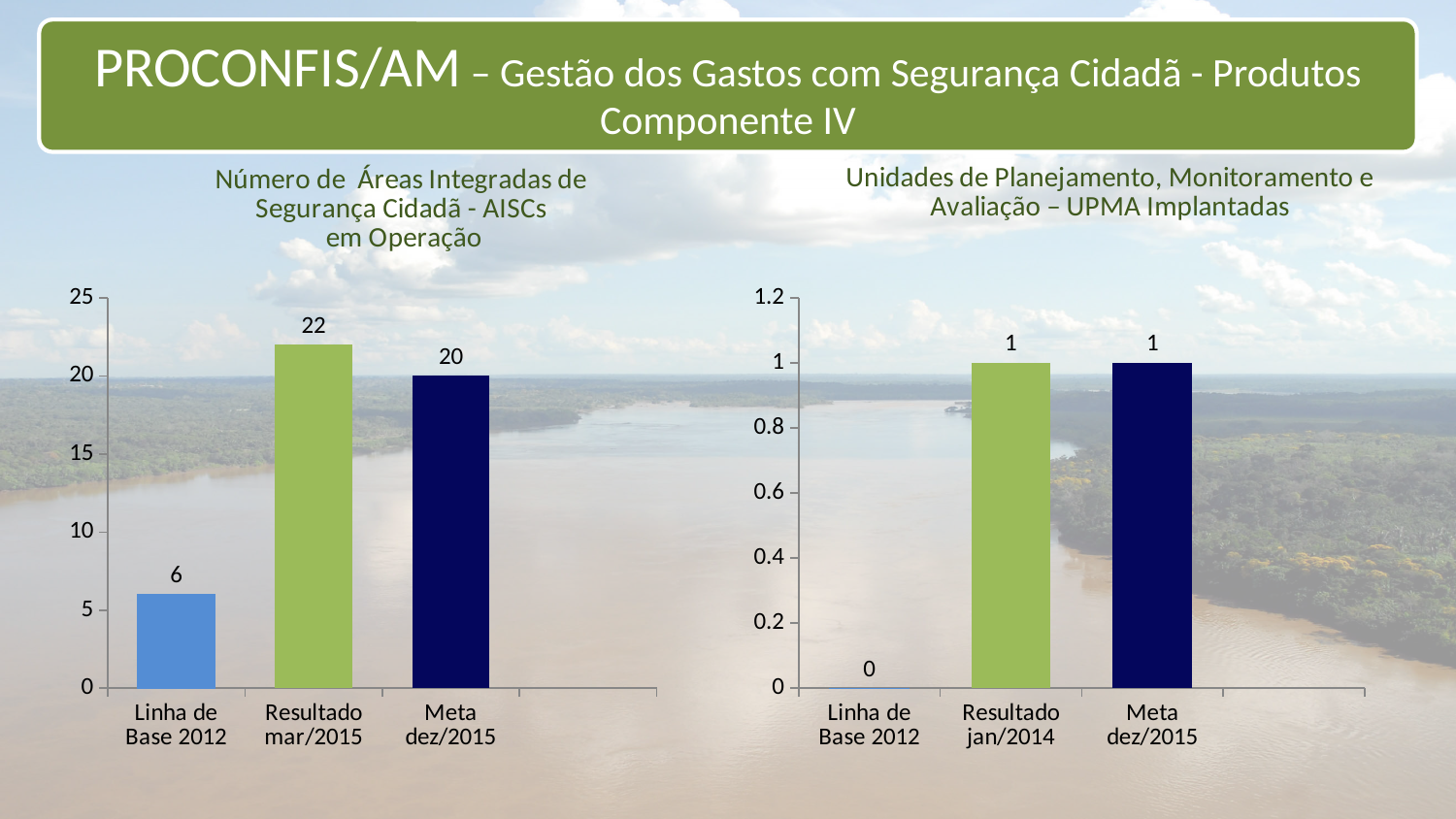
In the right chart (UPMA Implantadas), what is the value for Linha de Base 2012? 0 In the left chart (AISCs em Operação), what is the value for Resultado mar/2015? 22 In the left chart (AISCs em Operação), which category has the highest value? Resultado mar/2015 What type of chart is the left chart (AISCs em Operação)? Bar chart In the left chart (Número de Áreas Integradas de Segurança Cidadã - AISCs em Operação), what is the value for Linha de Base 2012? 6 In the left chart (AISCs em Operação), is the value for Resultado mar/2015 greater or less than 20? greater In the left chart (AISCs em Operação), which category has the lowest value? Linha de Base 2012 How many categories are shown in the right chart (UPMA Implantadas)? 3 In the left chart (AISCs em Operação), what is the value for Meta dez/2015? 20 In the right chart (UPMA Implantadas), which category has the lowest value? Linha de Base 2012 In the right chart (UPMA Implantadas), what is the value for Resultado jan/2014? 1 In the left chart (AISCs em Operação), what is the difference between Resultado mar/2015 and Meta dez/2015? 2